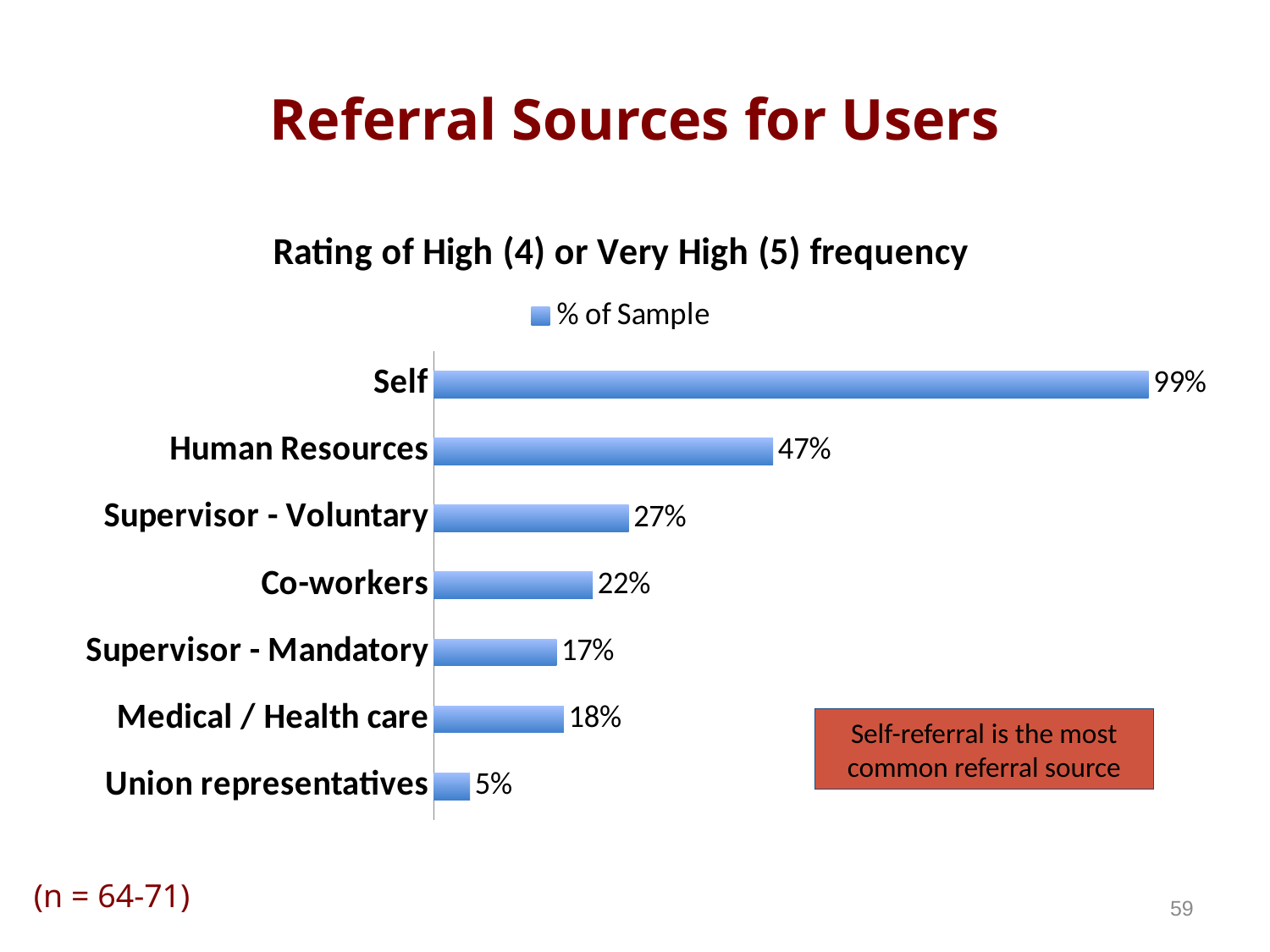
What is the difference between the values for Supervisor - Voluntary and Co-workers? 5% Which category has the highest value? Self What is the value for Self? 99% What is the value for Medical / Health care? 18% What is the value for Union representatives? 5% What is the value for Human Resources? 47% What is the difference between the values for Self and Human Resources? 52% How many categories are shown in the chart? 7 What kind of chart is shown on the slide? Bar chart Which category has the lowest value? Union representatives Which is larger, the value for Co-workers or the value for Supervisor - Mandatory? Co-workers What is the title of the chart? Rating of High (4) or Very High (5) frequency